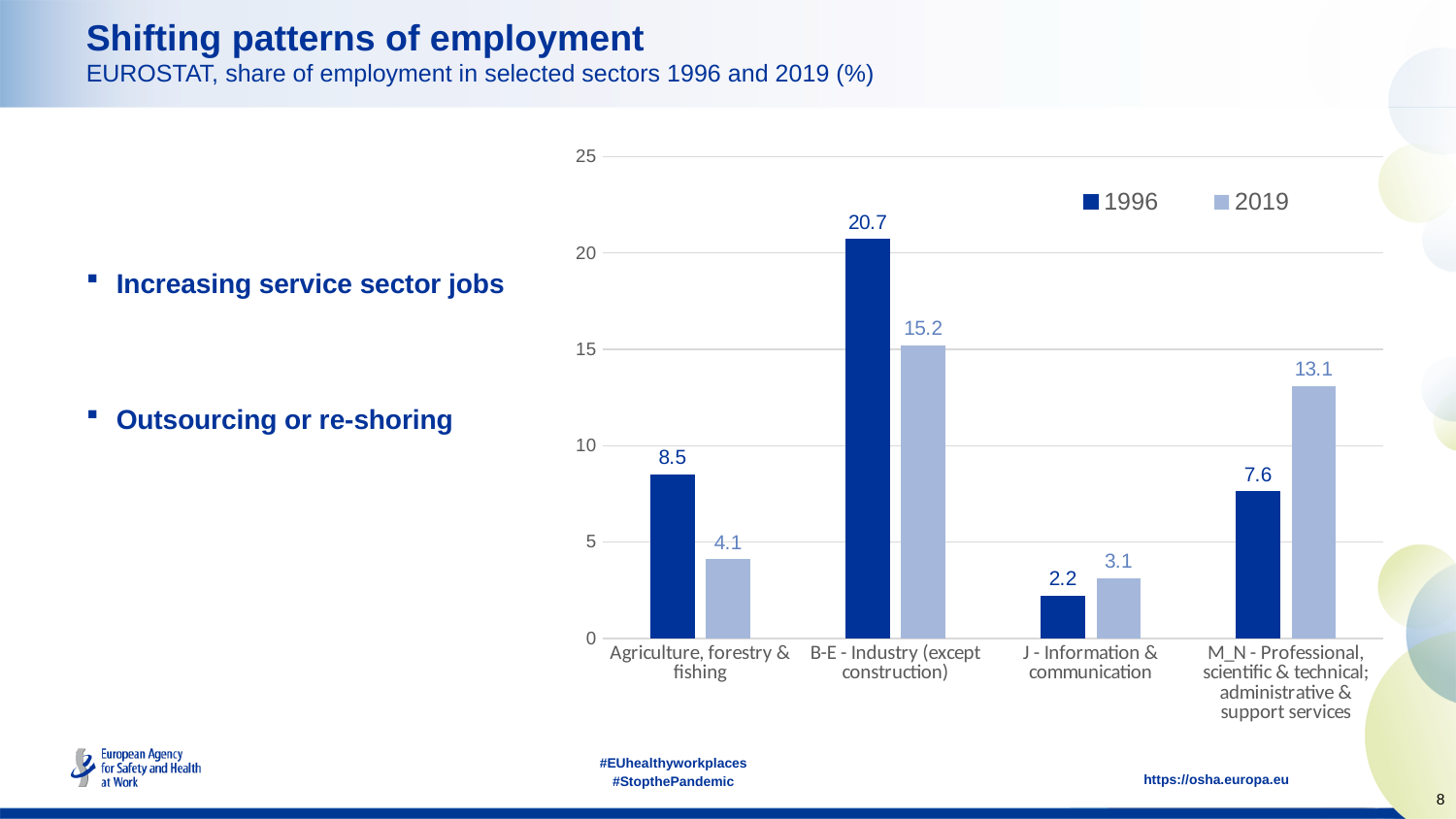
Is the 2019 value for M_N - Professional, scientific & technical; administrative & support services greater or less than 10? greater How many series does the legend list? 2 Which is larger: the 1996 share for Agriculture, forestry & fishing or the 1996 share for M_N - Professional, scientific & technical; administrative & support services? Agriculture, forestry & fishing What is the difference between the 2019 and 1996 shares for M_N - Professional, scientific & technical; administrative & support services? 5.5 Which sector had the highest share of employment in 1996? B-E - Industry (except construction) What was the share of employment in Agriculture, forestry & fishing in 1996? 8.5 How many sectors are shown on the chart? 4 What kind of chart is shown on the slide? Bar chart What was the share of employment in B-E - Industry (except construction) in 2019? 15.2 What was the share of employment in J - Information & communication in 2019? 3.1 By how much did the share of employment in B-E - Industry (except construction) change between 1996 and 2019? 5.5 Which sector had the lowest share of employment in 2019? J - Information & communication